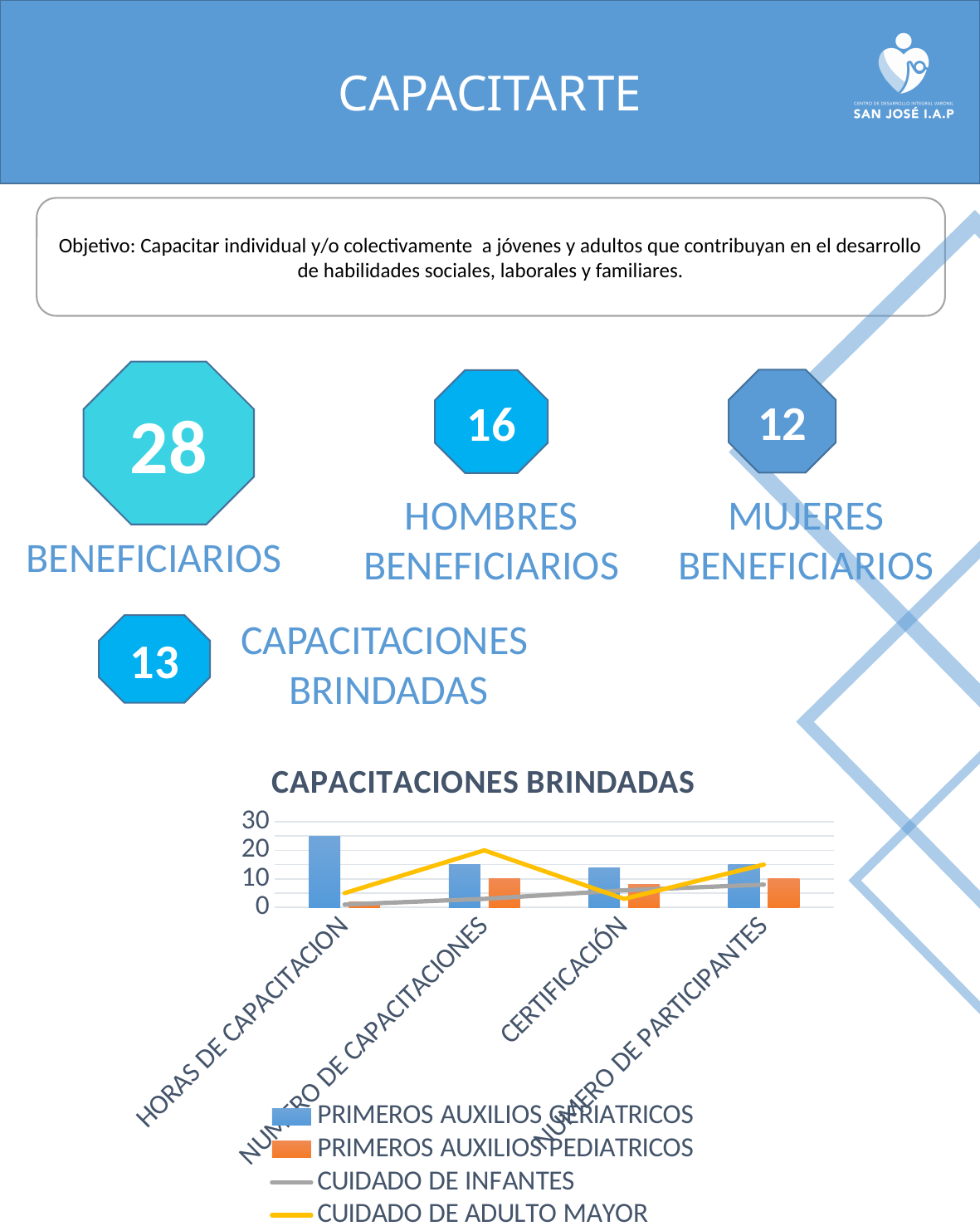
Which category has the lowest value for PRIMEROS AUXILIOS PEDIATRICOS? HORAS DE CAPACITACION Is the value for CUIDADO DE ADULTO MAYOR in CERTIFICACIÓN greater or less than 10? less What is the title of the chart on the slide? CAPACITACIONES BRINDADAS What kind of chart is shown on the slide? A combination chart with bars and lines Is the value for PRIMEROS AUXILIOS GERIATRICOS in HORAS DE CAPACITACION greater or less than 20? greater For CERTIFICACIÓN, which is larger: PRIMEROS AUXILIOS GERIATRICOS or PRIMEROS AUXILIOS PEDIATRICOS? PRIMEROS AUXILIOS GERIATRICOS Which category has the highest value for PRIMEROS AUXILIOS GERIATRICOS? HORAS DE CAPACITACION How many series does the chart legend list? 4 Which category has the highest value for CUIDADO DE ADULTO MAYOR? NUMERO DE CAPACITACIONES Does the CUIDADO DE INFANTES line rise or fall from HORAS DE CAPACITACION to NUMERO DE PARTICIPANTES? rise Which category has the lowest value for CUIDADO DE ADULTO MAYOR? CERTIFICACIÓN How many categories are shown on the x axis of the chart? 4